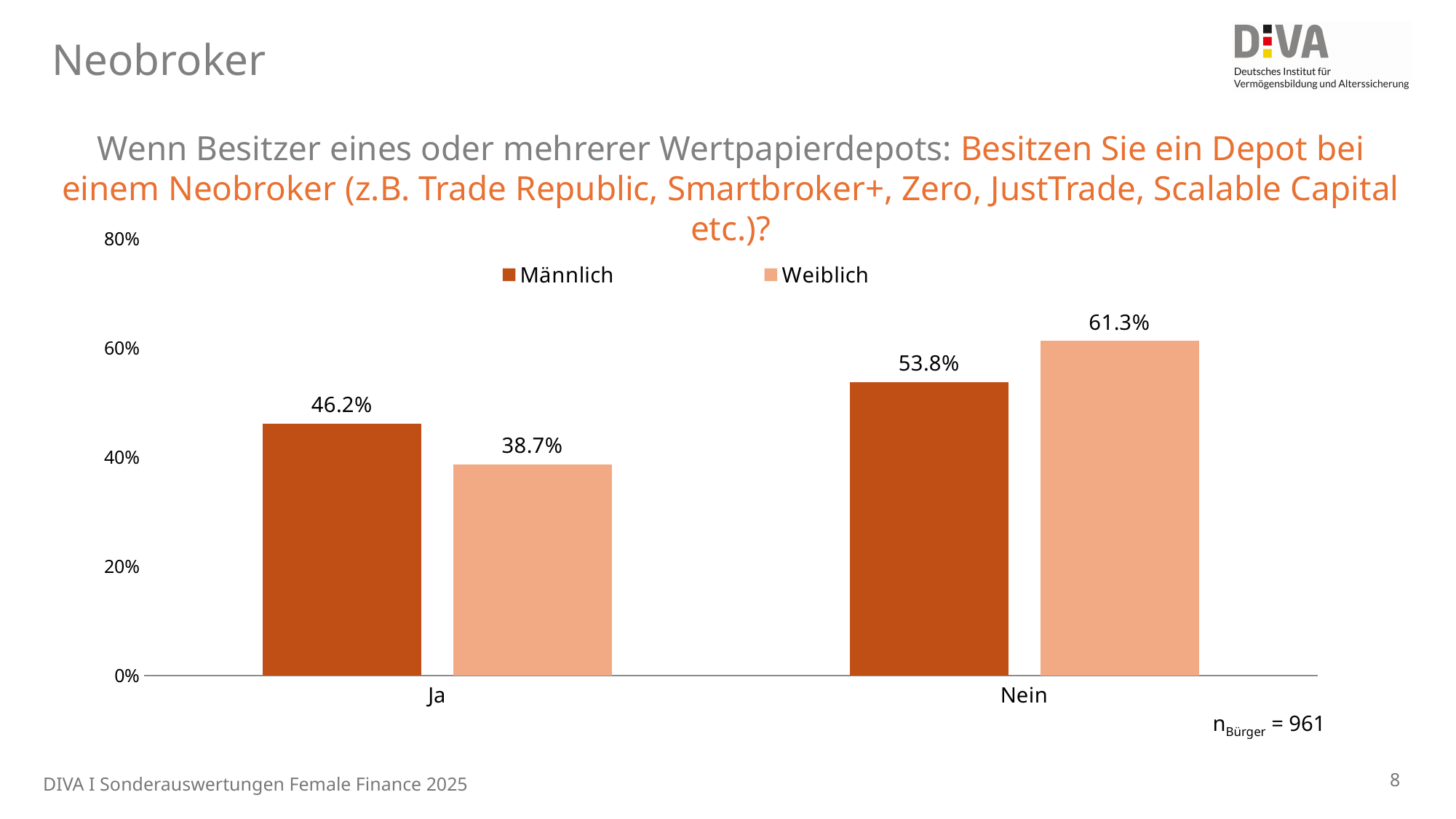
How many categories are shown on the x axis? 2 What is the value for Weiblich in the Nein category? 61.3% What is the value for Männlich in the Nein category? 53.8% In the Nein category, which is larger: Männlich or Weiblich? Weiblich What is the difference between the Männlich and Weiblich values in the Ja category? 7.5 percentage points How many series does the legend list? 2 What is the value for Männlich in the Ja category? 46.2% What kind of chart is shown on the slide? Bar chart What is the difference between the Weiblich and Männlich values in the Nein category? 7.5 percentage points What is the value for Weiblich in the Ja category? 38.7% Which bar has the highest value in the chart? Weiblich, Nein (61.3%) Which bar has the lowest value in the chart? Weiblich, Ja (38.7%)